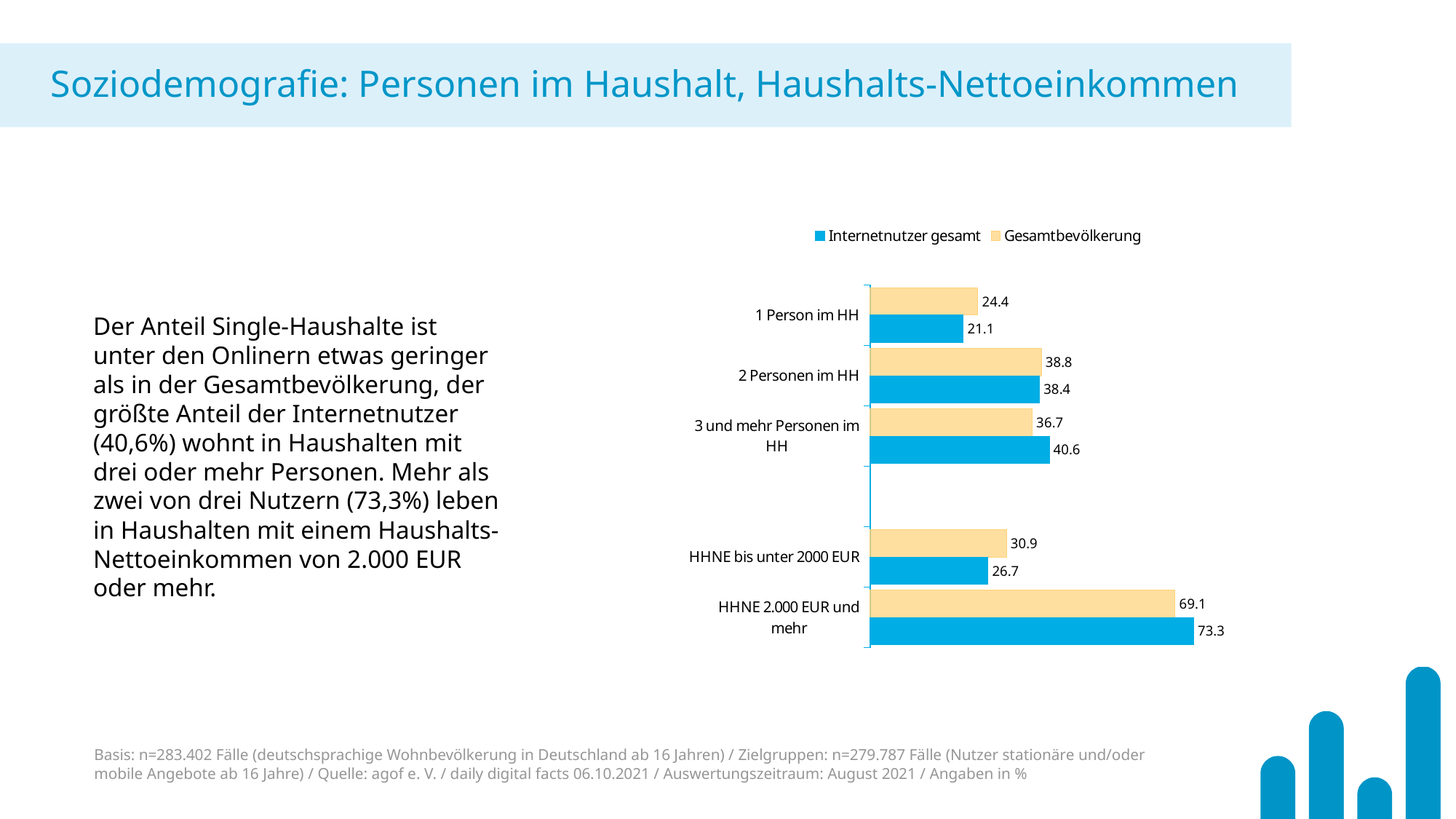
How many categories are shown on the chart? 5 Which category has the highest value for Internetnutzer gesamt? HHNE 2.000 EUR und mehr What kind of chart is shown on the slide? Bar chart What is the difference between the Internetnutzer gesamt and Gesamtbevölkerung values for 'HHNE 2.000 EUR und mehr'? 4.2 How many series does the legend list? 2 What is the value for Internetnutzer gesamt in the category '1 Person im HH'? 21.1 What is the value for Gesamtbevölkerung in the category '3 und mehr Personen im HH'? 36.7 For '3 und mehr Personen im HH', which series has the larger value: Internetnutzer gesamt or Gesamtbevölkerung? Internetnutzer gesamt What is the value for Gesamtbevölkerung in the category 'HHNE bis unter 2000 EUR'? 30.9 Which category has the lowest value for Gesamtbevölkerung? 1 Person im HH What is the difference between the Gesamtbevölkerung and Internetnutzer gesamt values for '1 Person im HH'? 3.3 For 'HHNE bis unter 2000 EUR', which series has the larger value: Internetnutzer gesamt or Gesamtbevölkerung? Gesamtbevölkerung